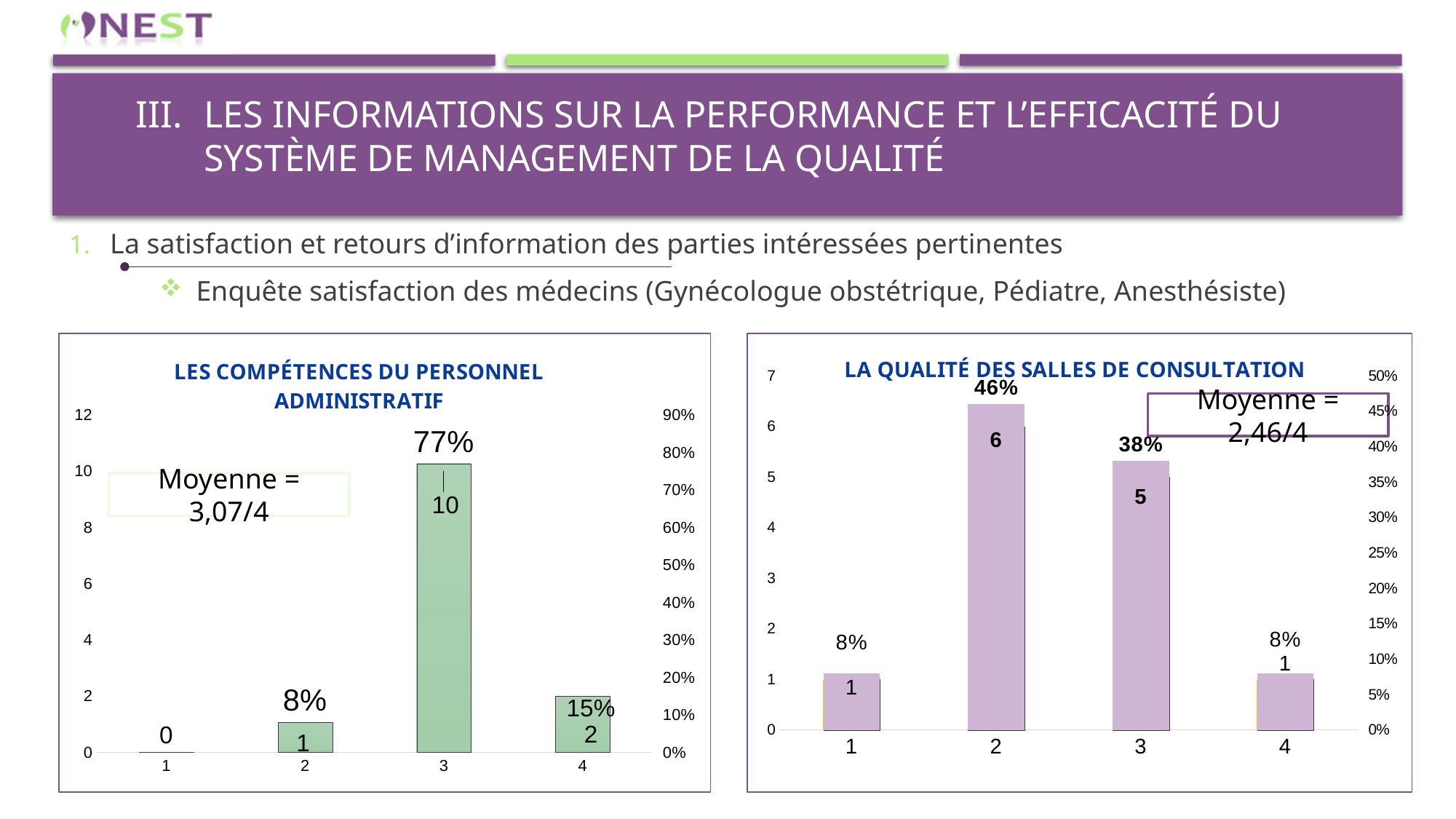
In the chart titled 'LA QUALITÉ DES SALLES DE CONSULTATION', which category has the highest count? 2 In the chart titled 'LES COMPÉTENCES DU PERSONNEL ADMINISTRATIF', what percentage is shown for category 4? 15% In the chart titled 'LA QUALITÉ DES SALLES DE CONSULTATION', is the count for category 2 larger or smaller than the count for category 3? larger In the chart titled 'LES COMPÉTENCES DU PERSONNEL ADMINISTRATIF', what is the count for category 3? 10 In the chart titled 'LA QUALITÉ DES SALLES DE CONSULTATION', how many categories are shown on the x axis? 4 In the chart titled 'LES COMPÉTENCES DU PERSONNEL ADMINISTRATIF', which category has the highest count? 3 In the chart titled 'LA QUALITÉ DES SALLES DE CONSULTATION', what is the count for category 2? 6 In the chart titled 'LES COMPÉTENCES DU PERSONNEL ADMINISTRATIF', which category has the lowest count? 1 In the chart titled 'LES COMPÉTENCES DU PERSONNEL ADMINISTRATIF', what is the difference between the counts for category 3 and category 4? 8 In the chart titled 'LES COMPÉTENCES DU PERSONNEL ADMINISTRATIF', what average (Moyenne) is shown? 3,07/4 What kind of chart is 'LA QUALITÉ DES SALLES DE CONSULTATION'? bar chart In the chart titled 'LA QUALITÉ DES SALLES DE CONSULTATION', what percentage is shown for category 3? 38%